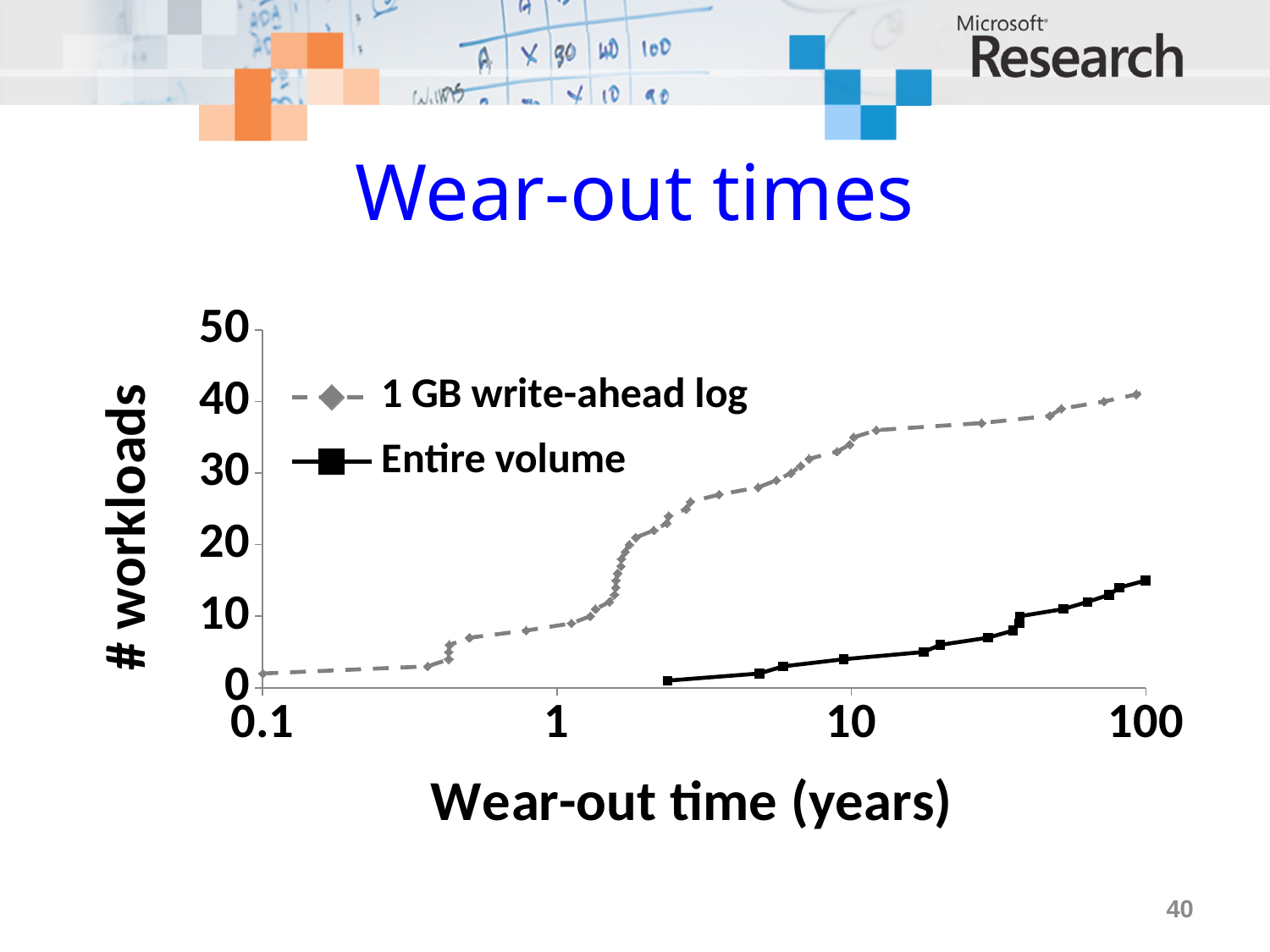
Is the value for the 1 GB write-ahead log series at a wear-out time of 10 years greater or less than 30? greater Is the value for the 1 GB write-ahead log series at a wear-out time of 1 year greater or less than 10? less Which series reaches the highest number of workloads on the chart? 1 GB write-ahead log What is the title of the chart? Wear-out times What kind of chart is shown on the slide? line chart At a wear-out time of 10 years, which series has the higher number of workloads, 1 GB write-ahead log or Entire volume? 1 GB write-ahead log How many series does the legend list? 2 Is the value for the Entire volume series at a wear-out time of 100 years greater or less than 10? greater What is the label of the x axis? Wear-out time (years) Do the values for the Entire volume series rise or fall as wear-out time increases? rise Do the values for the 1 GB write-ahead log series rise or fall as wear-out time increases? rise